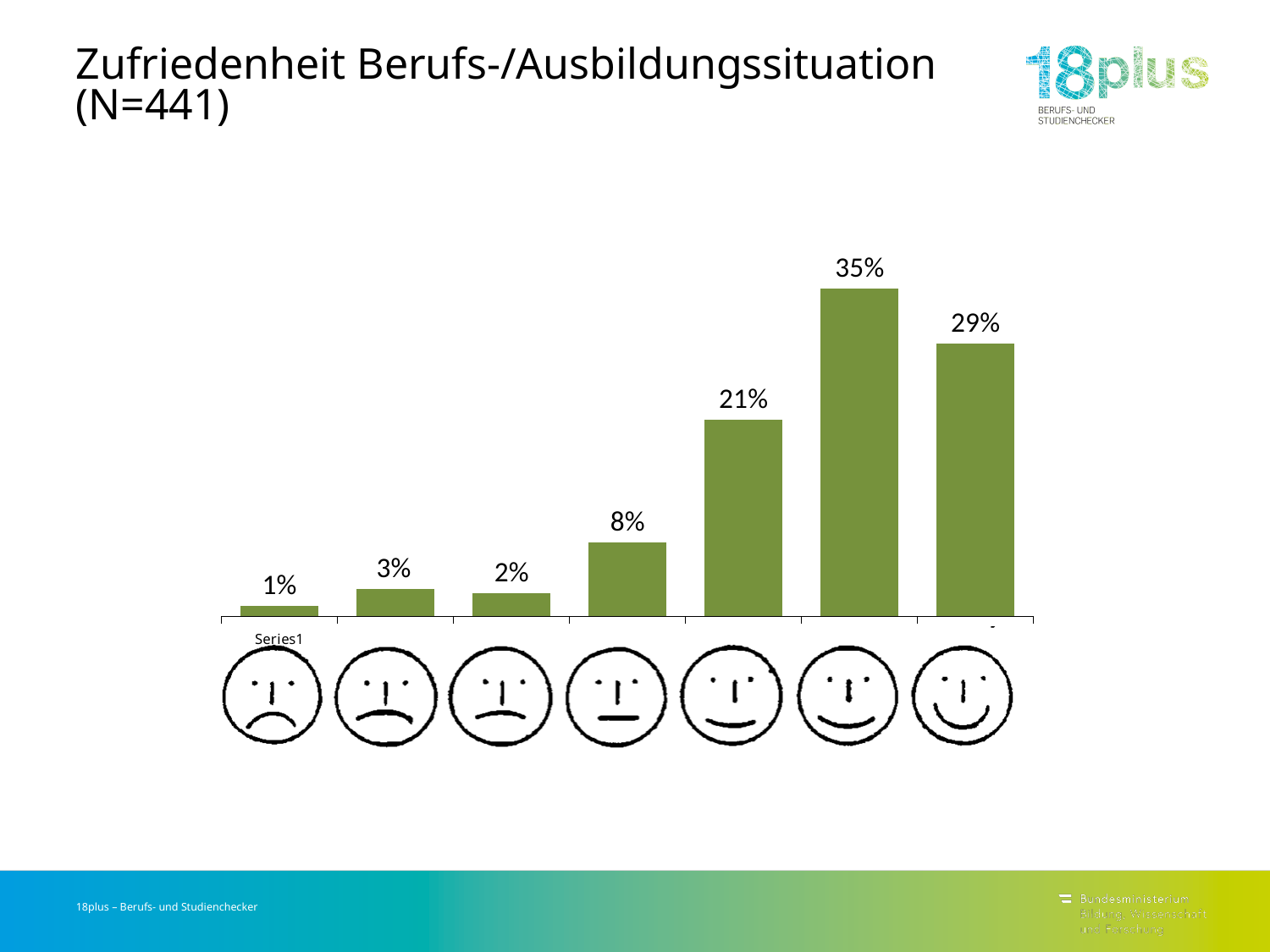
What type of chart is shown on the slide? bar chart What is the title of the chart on the slide? Zufriedenheit Berufs-/Ausbildungssituation (N=441) What is the value of the rightmost bar (the happiest face)? 29% Do the values generally rise or fall from left to right across the chart? rise Which bar has the lowest value? the leftmost bar (1%) What is the difference between the highest bar (35%) and the rightmost bar (29%)? 6% Which bar has the highest value? the sixth bar from the left (35%) What is the value of the fourth bar from the left (the neutral face)? 8% How many bars are plotted in the chart? 7 What is the value of the leftmost bar (the saddest face)? 1% What is the value of the fifth bar from the left? 21% Which is larger, the second bar from the left or the third bar from the left? the second bar (3%)